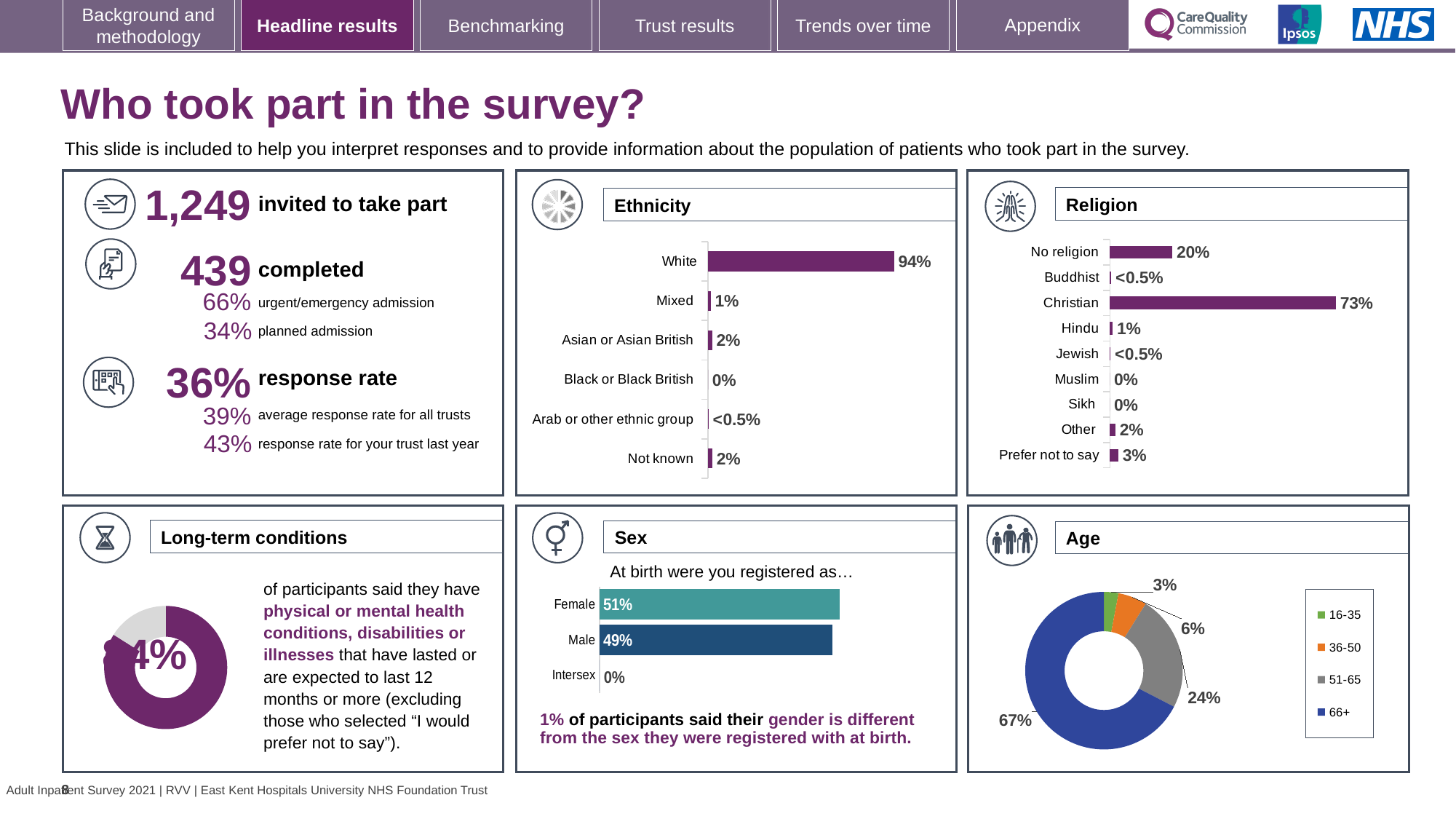
In the Ethnicity chart, what percentage of participants were White? 94% In the Religion chart, what percentage of participants were Christian? 73% In the Religion chart, what is the difference between the Christian and No religion values? 53% What kind of chart is the Sex chart? Bar chart How many categories are shown in the Ethnicity chart? 6 How many age groups does the legend of the Age chart list? 4 In the Ethnicity chart, what is the value for Arab or other ethnic group? <0.5% In the Ethnicity chart, which category has the highest value? White How many categories are shown in the Religion chart? 9 In the Religion chart, which is larger, Prefer not to say or Other? Prefer not to say In the Sex chart, what percentage of participants were registered as Female at birth? 51% In the Age chart, what share of participants were aged 66+? 67%